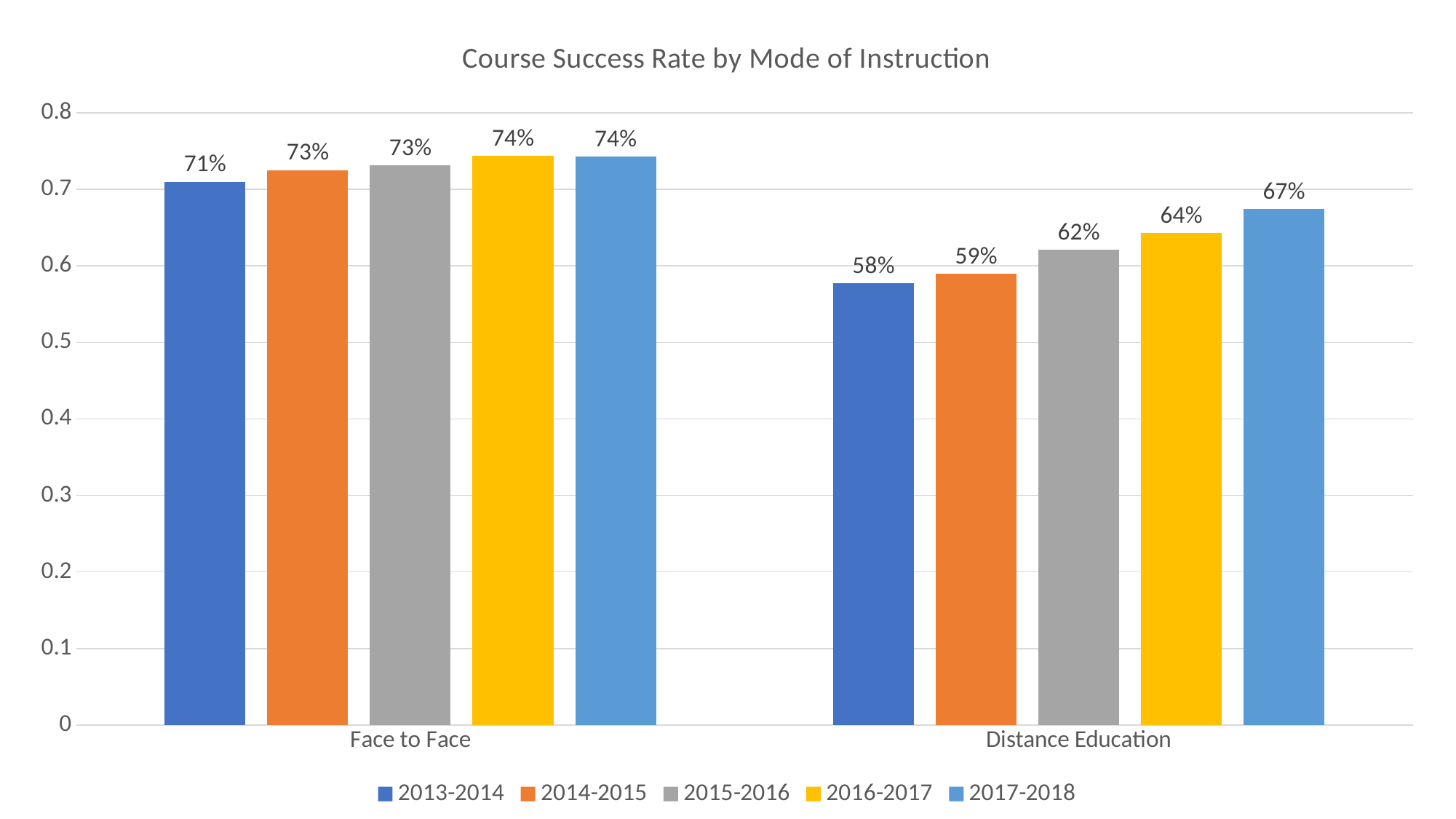
Do the Distance Education success rates rise or fall from 2013-2014 to 2017-2018? Rise What is the difference between the Face to Face and Distance Education success rates in 2013-2014? 13% What is the course success rate for Distance Education in 2017-2018? 67% How many series does the legend list? 5 What kind of chart is shown on the slide? Bar chart Is the 2014-2015 value for Distance Education greater or less than 0.6? less Which year has the lowest course success rate for Distance Education? 2013-2014 What is the course success rate for Face to Face in 2013-2014? 71% Which is larger, the 2016-2017 success rate for Face to Face or for Distance Education? Face to Face What is the course success rate for Distance Education in 2015-2016? 62% What is the difference between the 2017-2018 and 2013-2014 success rates for Distance Education? 9% How many modes of instruction are shown on the x axis? 2